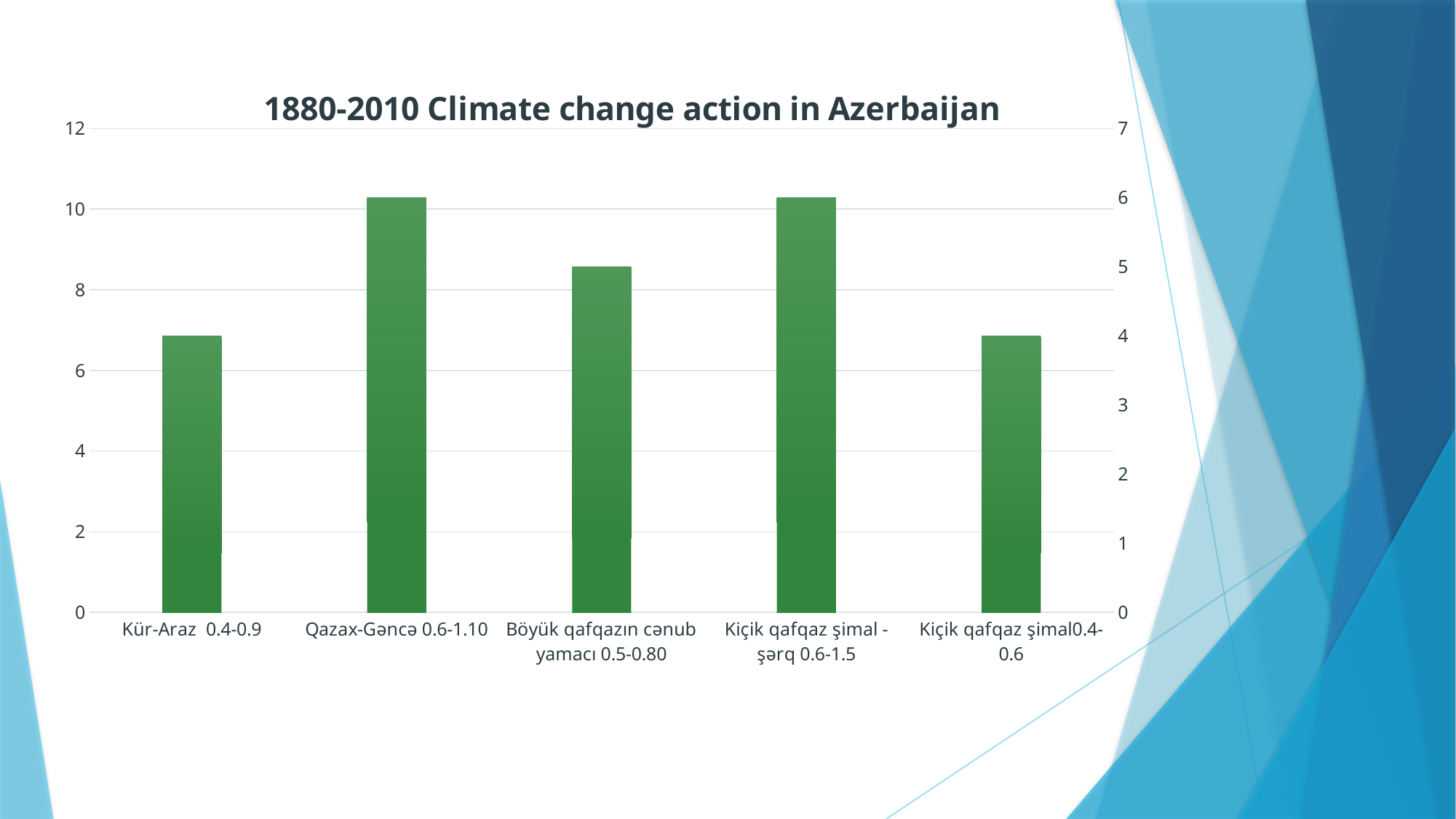
Which has the larger value: Qazax-Gəncə 0.6-1.10 or Böyük qafqazın cənub yamacı 0.5-0.80? Qazax-Gəncə 0.6-1.10 Is the value for Kiçik qafqaz şimal0.4-0.6 greater or less than 8 on the left-hand axis? less Is the value for Kür-Araz 0.4-0.9 greater or less than 8 on the left-hand axis? less What is the highest tick value shown on the left-hand vertical axis? 12 Is the value for Qazax-Gəncə 0.6-1.10 greater or less than 10 on the left-hand axis? greater What is the title of the chart? 1880-2010 Climate change action in Azerbaijan What kind of chart is shown on the slide? bar chart Which has the larger value: Böyük qafqazın cənub yamacı 0.5-0.80 or Kür-Araz 0.4-0.9? Böyük qafqazın cənub yamacı 0.5-0.80 Which has the larger value: Kiçik qafqaz şimal - şərq 0.6-1.5 or Kiçik qafqaz şimal0.4-0.6? Kiçik qafqaz şimal - şərq 0.6-1.5 How many categories (bars) are shown in the chart? 5